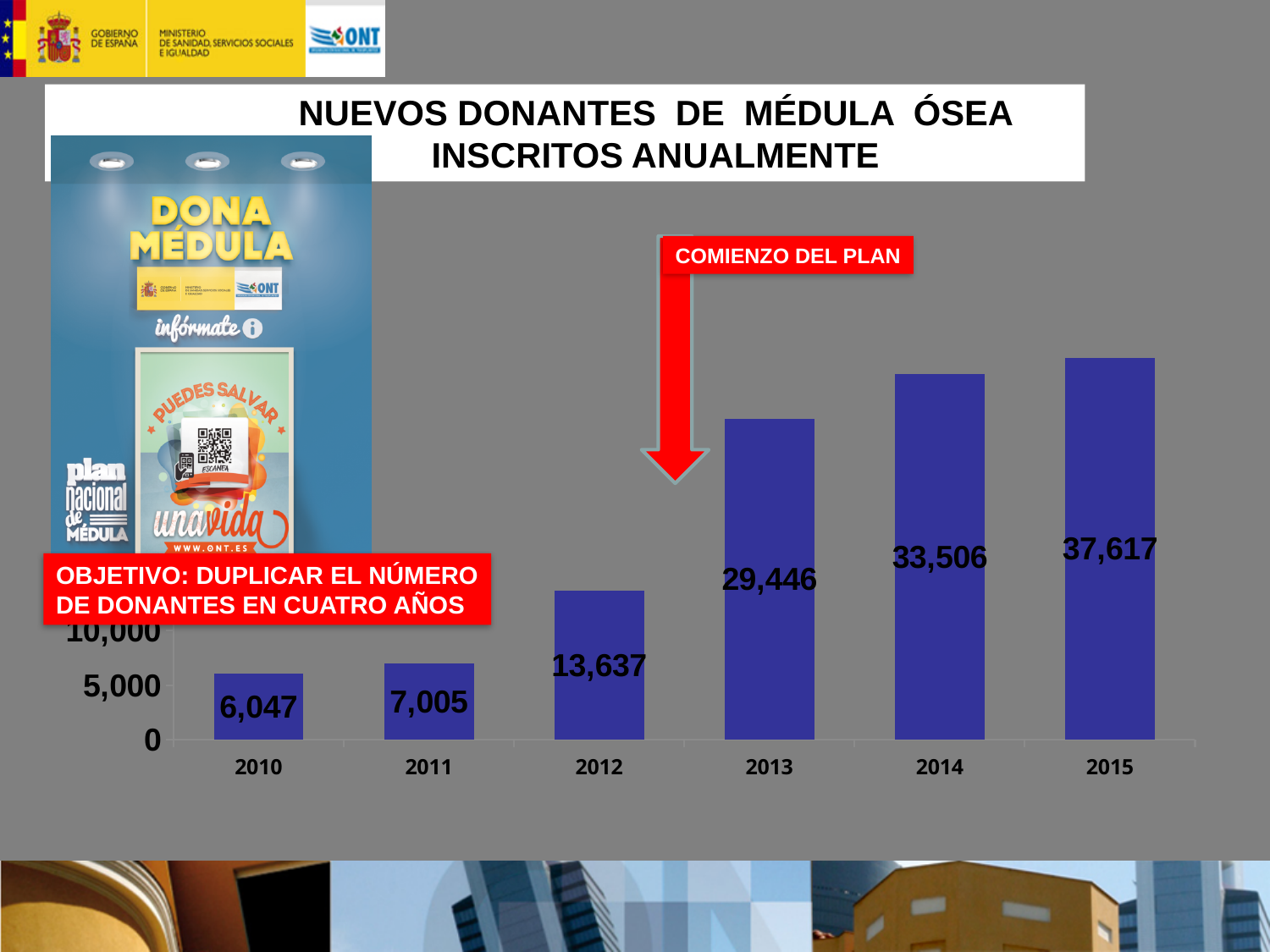
Which year has the lowest value? 2010 What is the value for 2010? 6,047 What is the title of the chart? NUEVOS DONANTES DE MÉDULA ÓSEA INSCRITOS ANUALMENTE What kind of chart is shown on the slide? bar chart What is the difference between the values for 2013 and 2012? 15,809 What is the value for 2015? 37,617 Which is larger, the value for 2011 or the value for 2012? 2012 What is the difference between the values for 2015 and 2010? 31,570 Which year has the highest value? 2015 How many years are shown on the x axis? 6 What is the value for 2013? 29,446 Do the values rise or fall from 2010 to 2015? rise